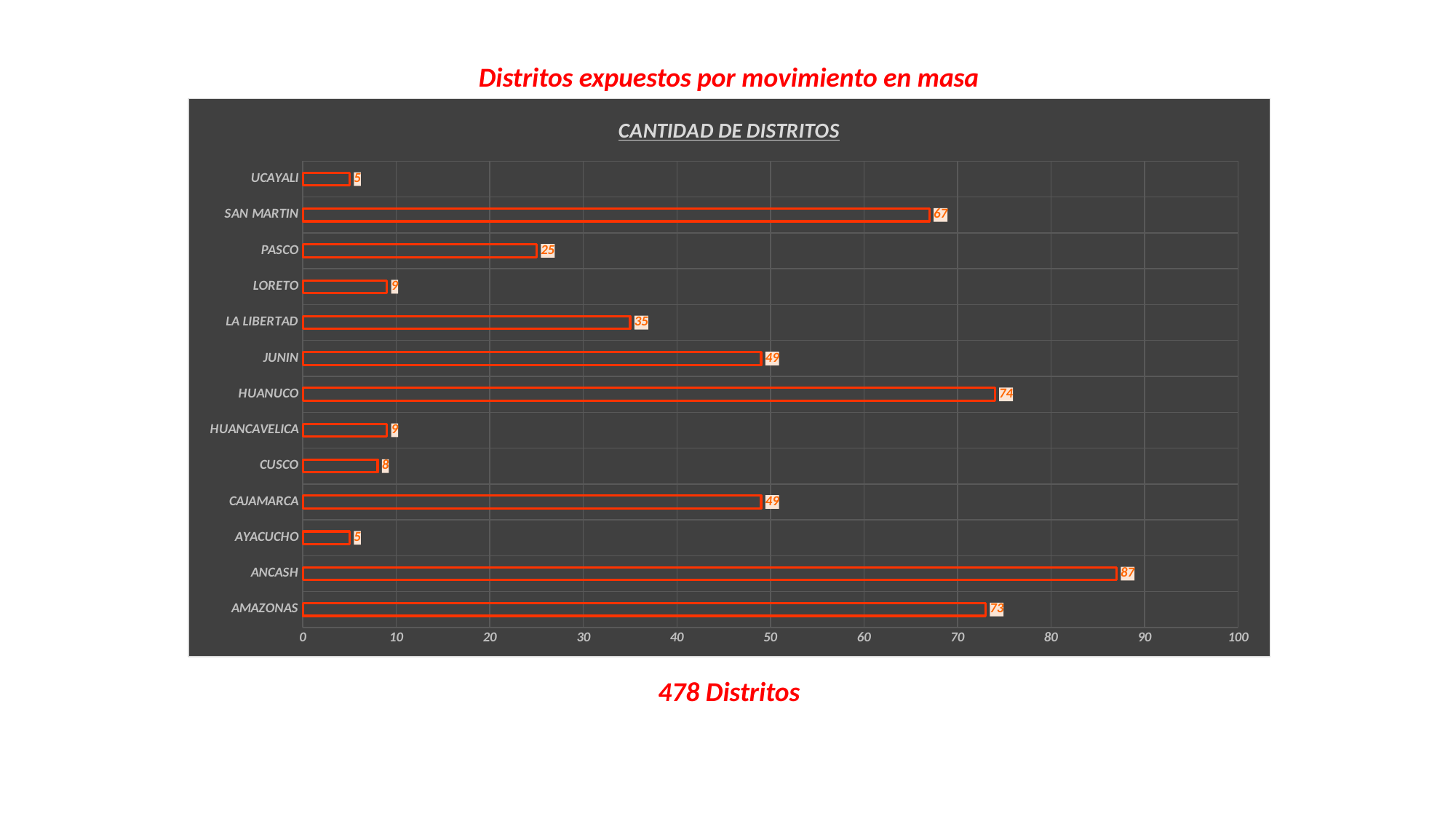
What is the difference between the values for ANCASH and HUANUCO? 13 What kind of chart is shown on the slide? bar chart What is the value for HUANUCO? 74 Which is larger, the value for AMAZONAS or the value for SAN MARTIN? AMAZONAS How many categories are shown on the chart? 13 Which category has the highest value? ANCASH What is the value for CUSCO? 8 What is the title of the chart? CANTIDAD DE DISTRITOS What is the value for PASCO? 25 Is the value for JUNIN greater or less than 40? greater What is the difference between the values for SAN MARTIN and LA LIBERTAD? 32 What is the value for ANCASH? 87